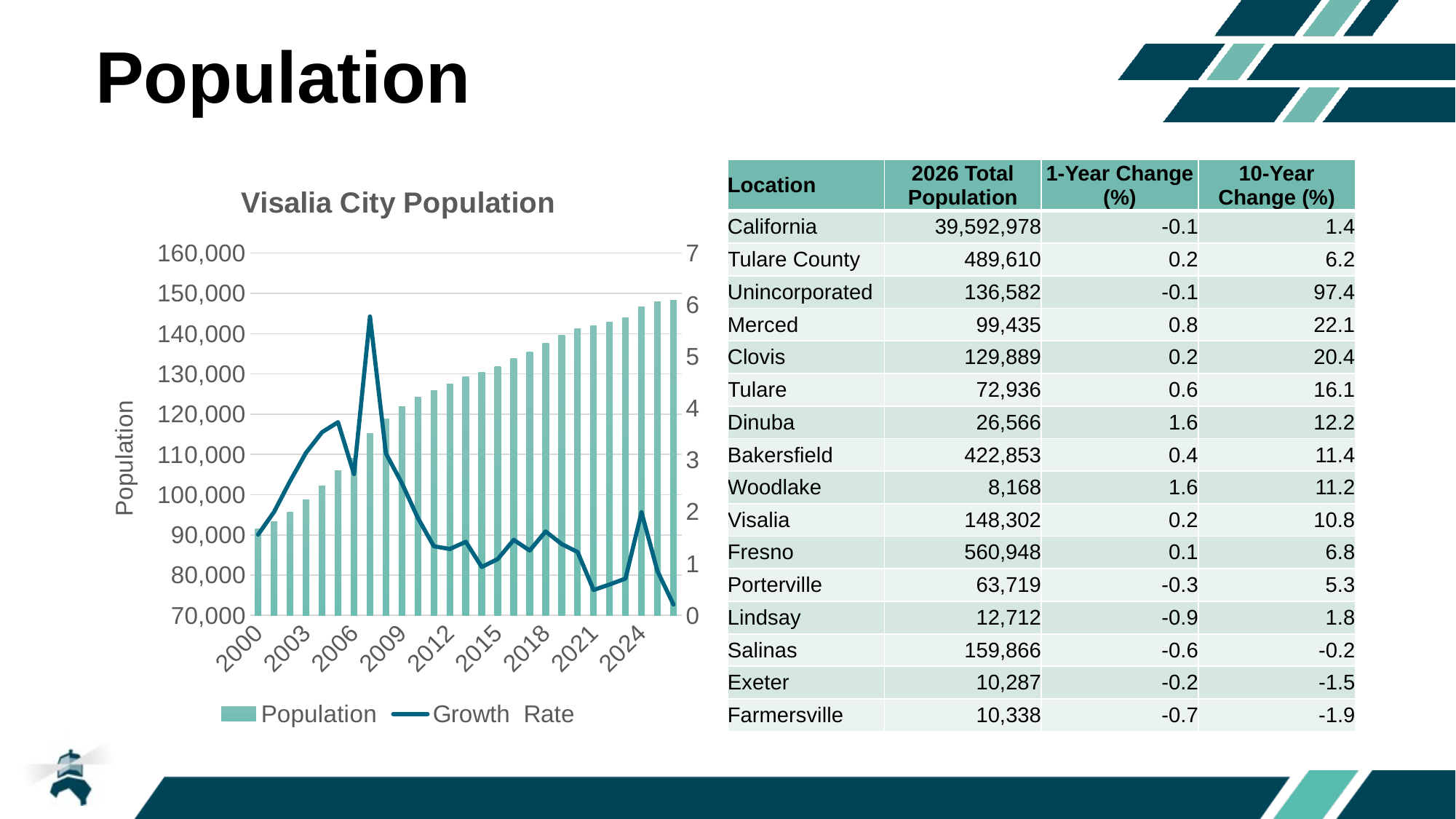
What are the two series named in the legend of the Visalia City Population chart? Population and Growth Rate In the Visalia City Population chart, does the Population series rise or fall from 2000 to the final year shown? rise In the Visalia City Population chart, which year has the lowest Population bar? 2000 In the Visalia City Population chart, is the peak Growth Rate value greater or less than 5? greater In the Visalia City Population chart, is the Population value for 2012 greater or less than 120,000? greater In the Visalia City Population chart, is the Population value for 2024 greater or less than 140,000? greater What kind of chart is the Visalia City Population chart? A combined bar and line chart What is the title of the chart on the slide? Visalia City Population In the Visalia City Population chart, which is larger, the Growth Rate in 2003 or the Growth Rate in 2021? 2003 How many series does the legend of the Visalia City Population chart list? 2